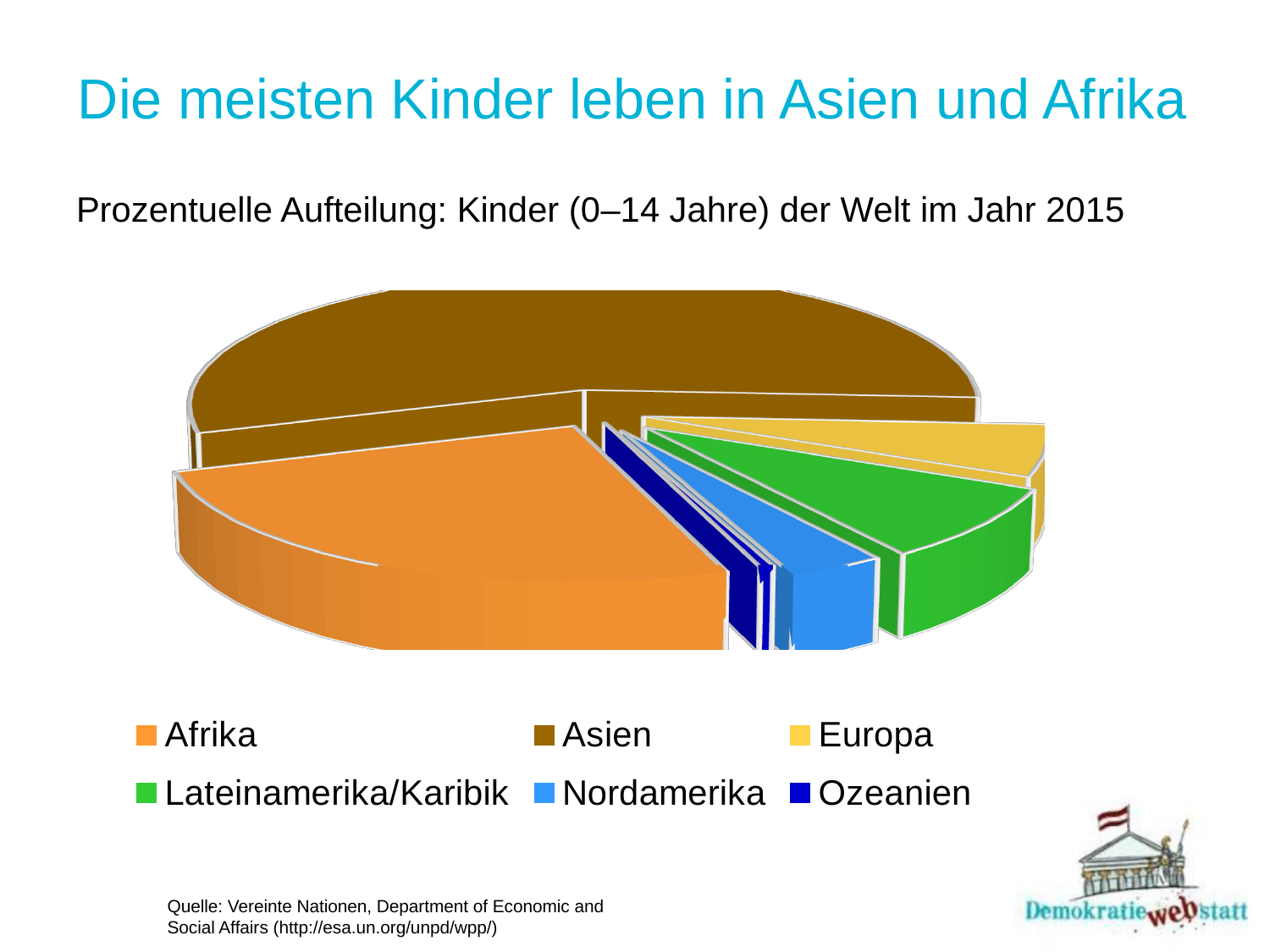
Which region has the smallest slice of the pie chart? Ozeanien Which slice is larger, Nordamerika or Ozeanien? Nordamerika What is the title of the slide containing the pie chart? Die meisten Kinder leben in Asien und Afrika How many slices does the pie chart have? 6 Which slice is larger, Asien or Afrika? Asien Which slice is larger, Afrika or Nordamerika? Afrika Which region has the largest slice of the pie chart? Asien What kind of chart is shown on the slide? pie chart Which colour represents Afrika in the pie chart? orange How many entries does the legend of the pie chart list? 6